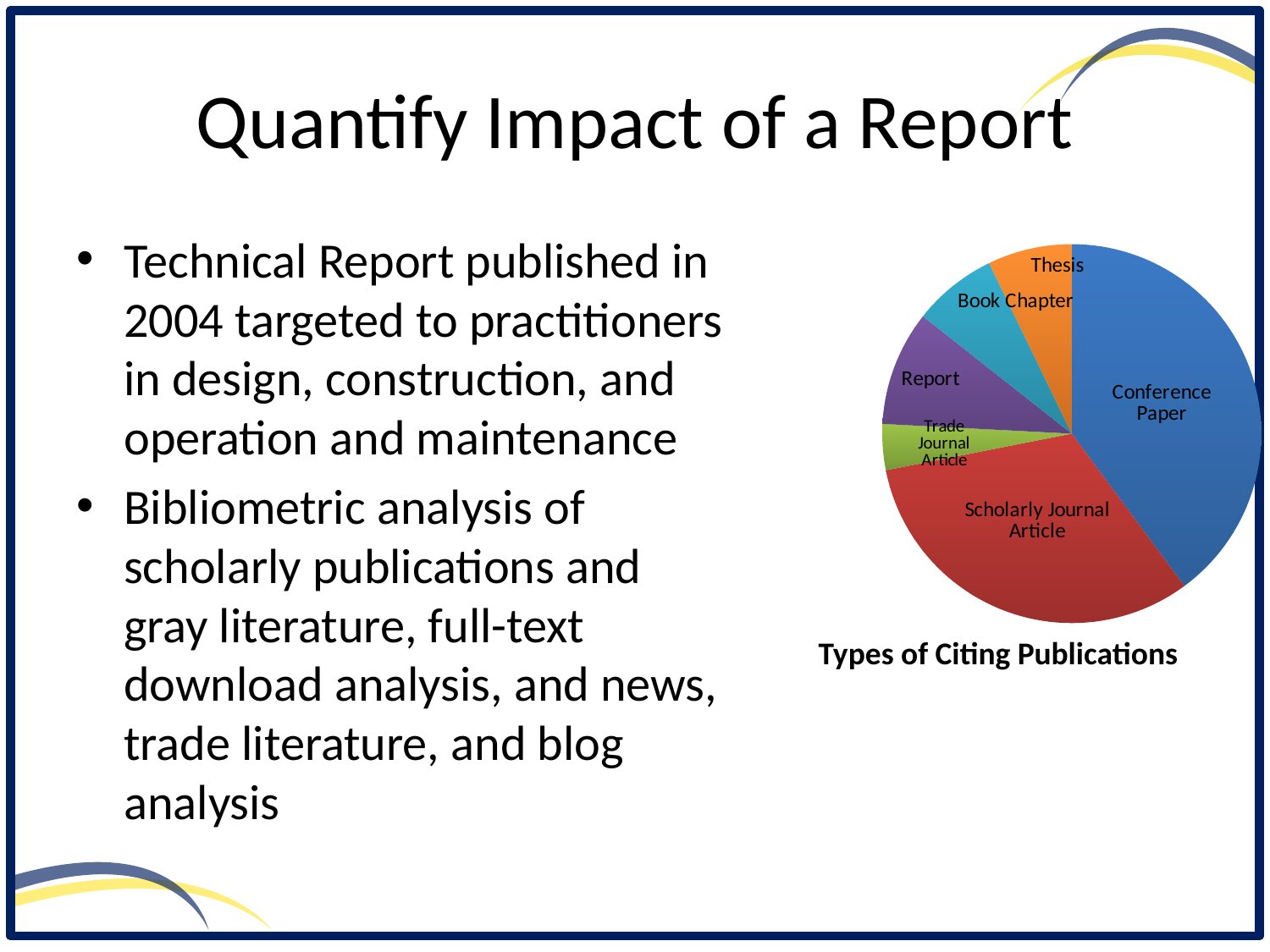
Which slice is larger, Scholarly Journal Article or Report? Scholarly Journal Article Which type of citing publication has the smallest slice of the pie? Trade Journal Article Which slice is larger, Thesis or Trade Journal Article? Thesis What colour is the Scholarly Journal Article slice? red What is the title shown below the pie chart? Types of Citing Publications Which slice is larger, Conference Paper or Scholarly Journal Article? Conference Paper How many slices does the pie chart have? 6 What kind of chart is shown on the slide? pie chart Which type of citing publication has the largest slice of the pie? Conference Paper